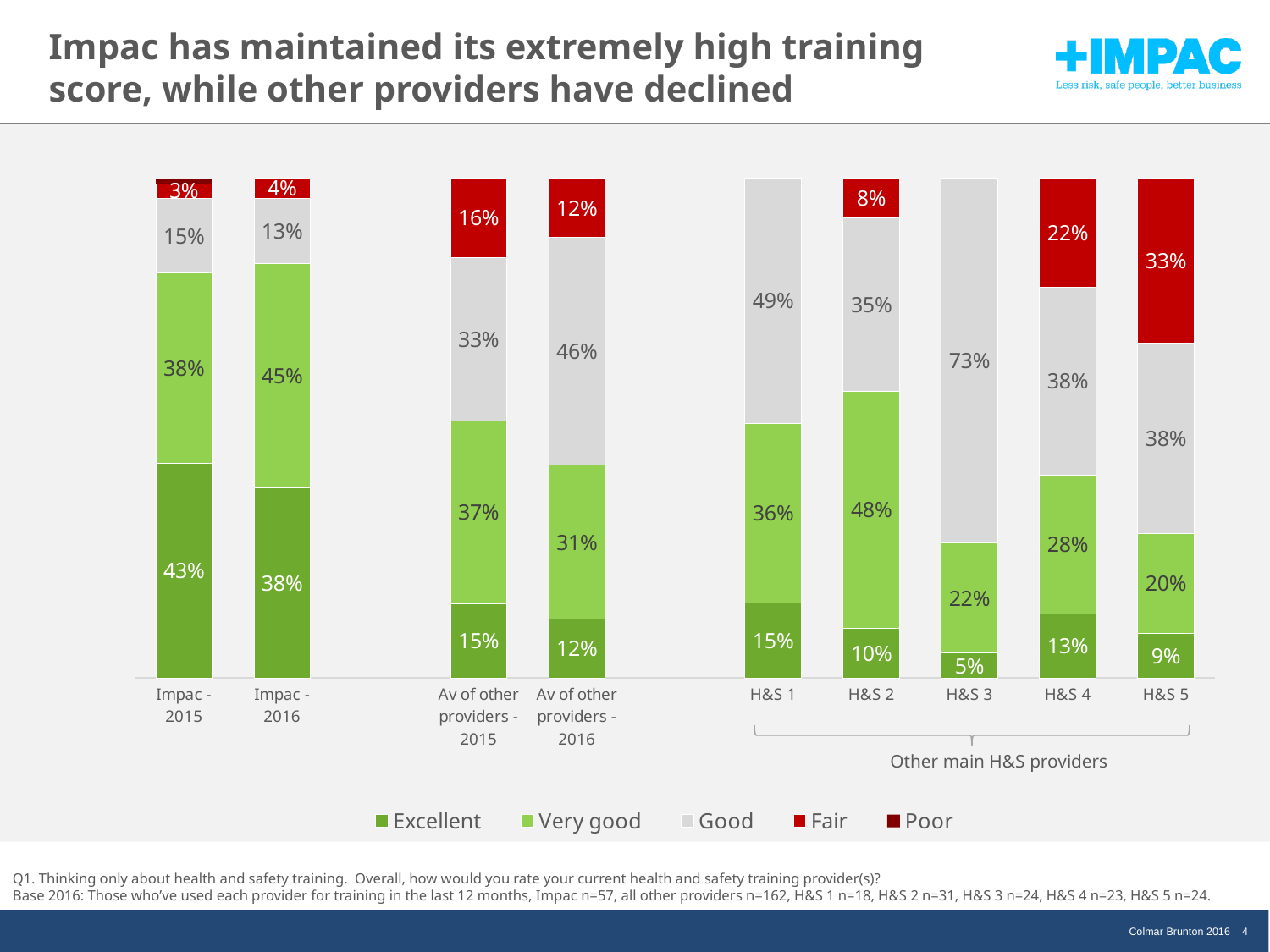
Which category has the highest Excellent share? Impac - 2015 How many categories are shown along the x axis? 9 What is the Fair share for Av of other providers - 2016? 12% What is the Very good share for H&S 2? 48% What is the Good share for H&S 3? 73% Which category has the lowest Excellent share? H&S 3 What is the total of the H&S 1 stacked bar (Excellent, Very good and Good)? 100% What percentage of Impac - 2015 respondents rated training as Excellent? 43% How many series does the legend list? 5 What is the difference in Excellent share between Impac - 2016 and Av of other providers - 2016? 26 percentage points What kind of chart is shown on the slide? Stacked bar chart Which has a larger Fair share, H&S 4 or H&S 5? H&S 5